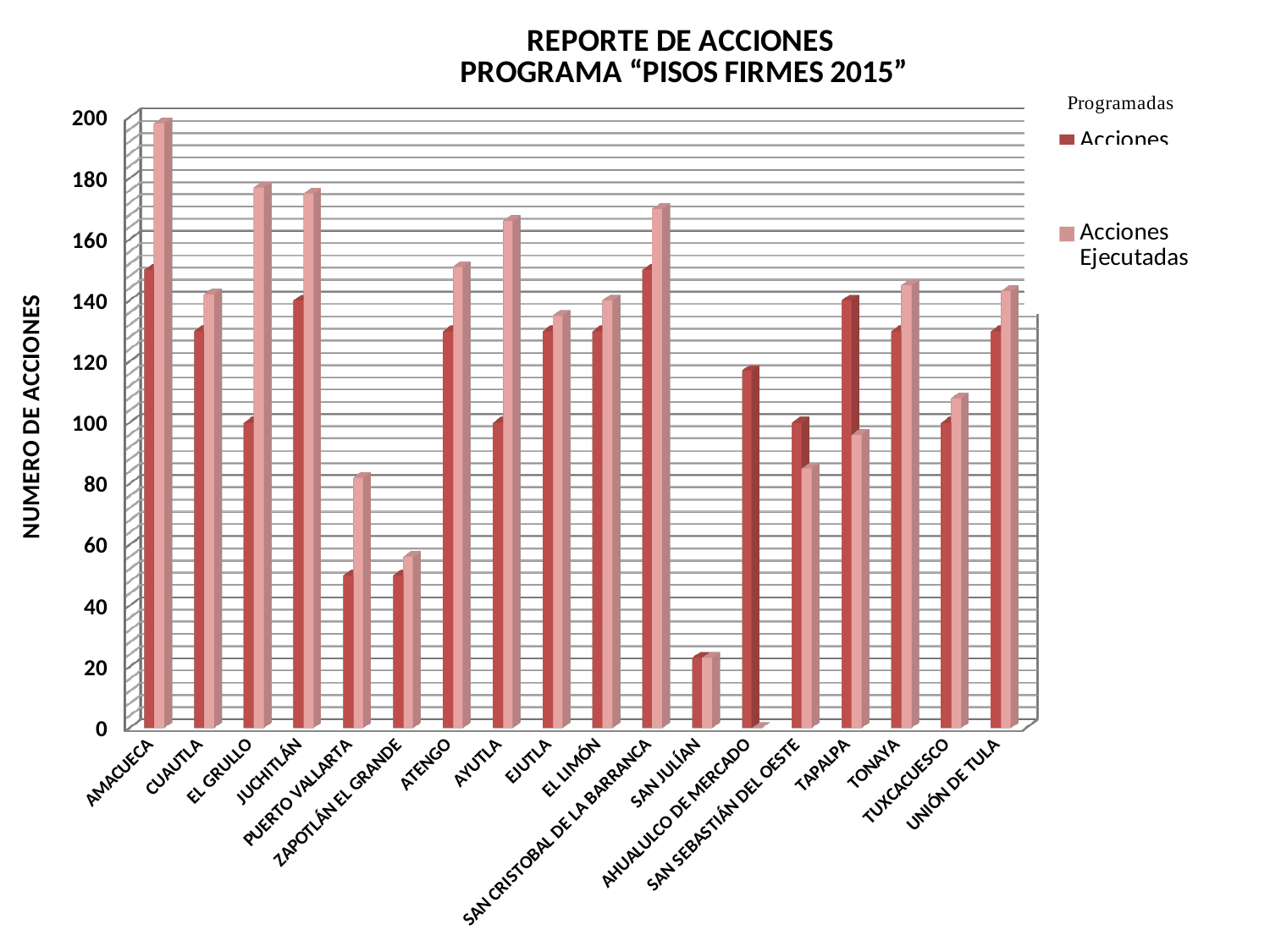
What is the title of the chart? REPORTE DE ACCIONES PROGRAMA "PISOS FIRMES 2015" For EL GRULLO, which is larger: Acciones Programadas or Acciones Ejecutadas? Acciones Ejecutadas How many series does the legend list? 2 Which municipality has the highest value for Acciones Ejecutadas? AMACUECA Is the value of Acciones Ejecutadas for AMACUECA greater or less than 180? greater Which municipality has the lowest value for Acciones Programadas? SAN JULÍAN What is the label of the vertical axis? NUMERO DE ACCIONES What kind of chart is shown on the slide? bar chart Is the value of Acciones Programadas for SAN JULÍAN greater or less than 40? less For TAPALPA, which is larger: Acciones Programadas or Acciones Ejecutadas? Acciones Programadas Is the value of Acciones Ejecutadas for JUCHITLÁN greater or less than 160? greater How many municipalities (categories) are shown on the x axis? 18